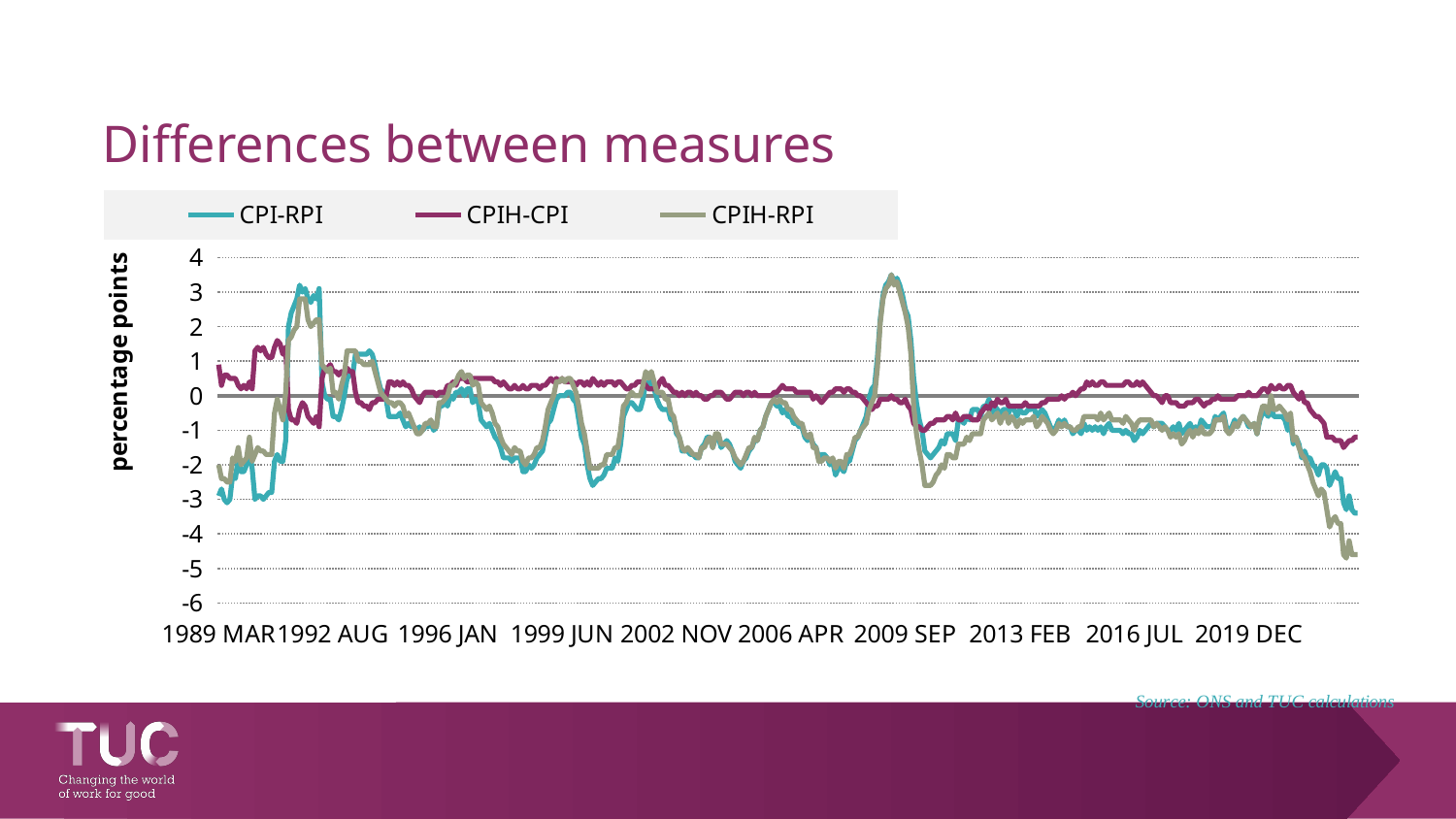
How many date labels are shown along the x axis? 10 How many series does the legend list? 3 Is the peak value for CPIH-RPI around 2009 SEP greater or less than 2? greater Is the value for CPI-RPI at the end of the series (around 2019 DEC) greater or less than -2? less What is the title of the chart? Differences between measures Is the value for CPIH-CPI at the end of the series (around 2019 DEC) greater or less than -2? greater At the end of the series (around 2019 DEC), which is lower: CPIH-RPI or CPIH-CPI? CPIH-RPI What kind of chart is shown on the slide? line chart What is the label on the vertical axis? percentage points